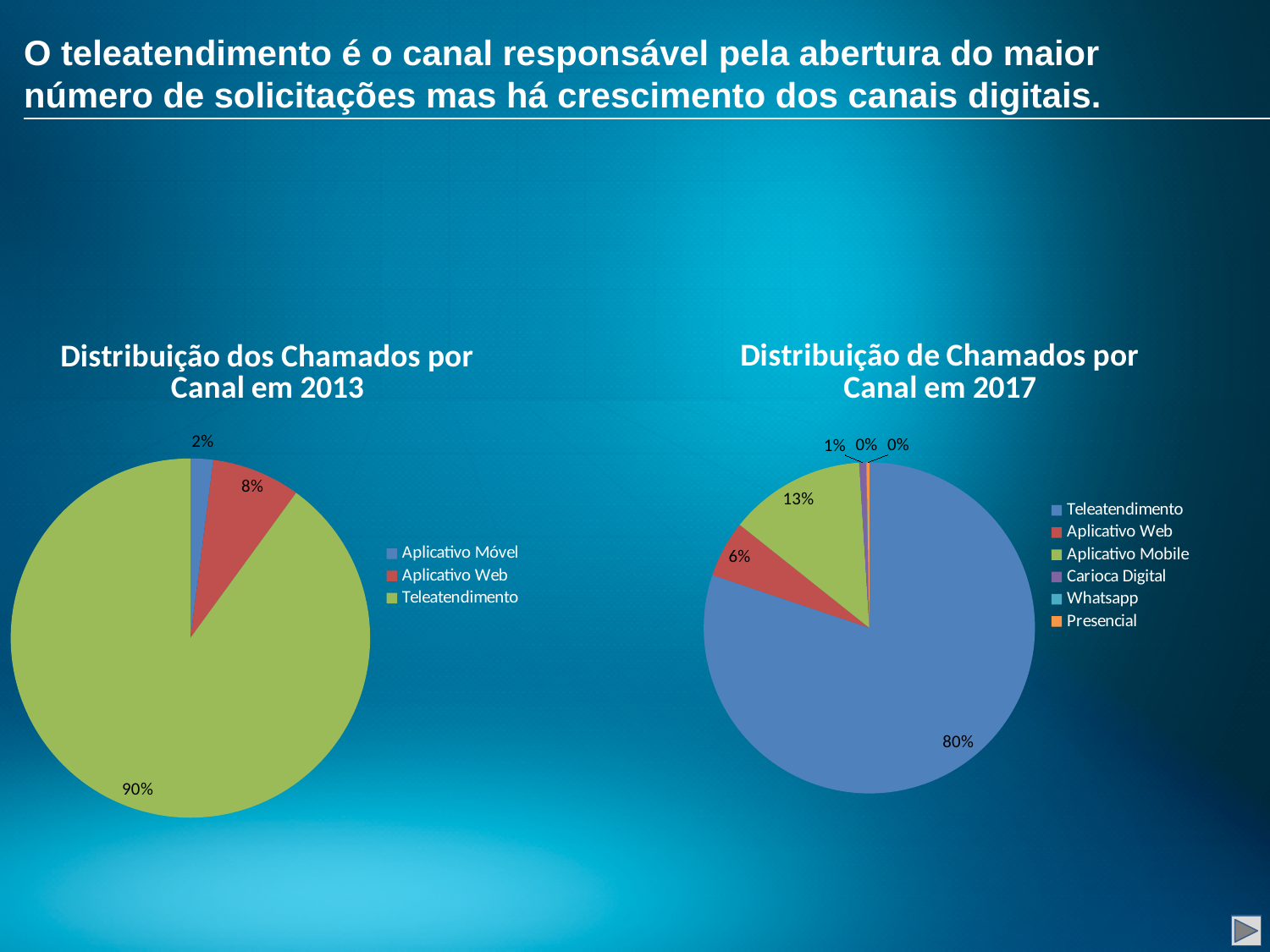
In the 'Distribuição dos Chamados por Canal em 2013' chart, what share does Teleatendimento have? 90% How many channels does the legend of the 'Distribuição de Chamados por Canal em 2017' chart list? 6 What type of chart is 'Distribuição dos Chamados por Canal em 2013'? Pie chart In the 'Distribuição de Chamados por Canal em 2017' chart, which channel has the largest share? Teleatendimento In the 'Distribuição de Chamados por Canal em 2017' chart, what share does Teleatendimento have? 80% In the 'Distribuição de Chamados por Canal em 2017' chart, what share does Aplicativo Mobile have? 13% In the 'Distribuição dos Chamados por Canal em 2013' chart, which channel has the smallest share? Aplicativo Móvel In the 2017 chart, is the share for Aplicativo Mobile larger or smaller than the share for Aplicativo Web? Larger In the 'Distribuição dos Chamados por Canal em 2013' chart, what share does Aplicativo Móvel have? 2% In the 'Distribuição dos Chamados por Canal em 2013' chart, what share does Aplicativo Web have? 8% What is the difference between the Teleatendimento share in the 2013 chart and in the 2017 chart? 10 percentage points In the 'Distribuição de Chamados por Canal em 2017' chart, what share does Aplicativo Web have? 6%